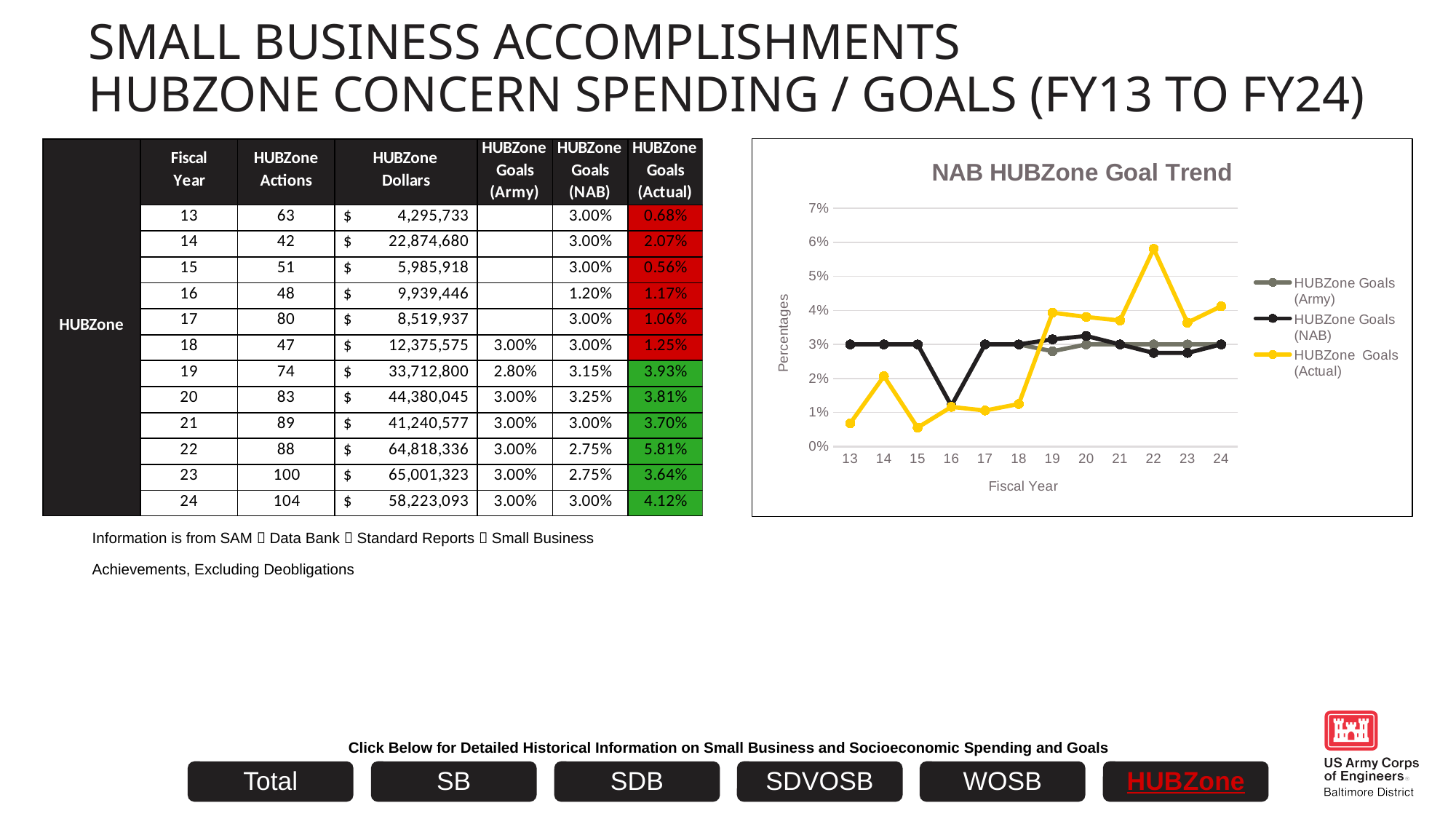
In fiscal year 19, which is larger: HUBZone Goals (Actual) or HUBZone Goals (NAB)? HUBZone Goals (Actual) How many series does the legend of the NAB HUBZone Goal Trend chart list? 3 What kind of chart is the NAB HUBZone Goal Trend chart? line chart What is the difference between the HUBZone Goals (Actual) values for fiscal year 22 and fiscal year 23? 2.17% What is the HUBZone Goals (NAB) value for fiscal year 16? 1.20% In the NAB HUBZone Goal Trend chart, is the HUBZone Goals (Actual) value for fiscal year 22 greater or less than 5%? greater What is the HUBZone Goals (Actual) value for fiscal year 24? 4.12% How many fiscal years are shown on the x axis of the NAB HUBZone Goal Trend chart? 12 In the NAB HUBZone Goal Trend chart, in which fiscal year is the HUBZone Goals (Actual) value highest? 22 In the NAB HUBZone Goal Trend chart, is the HUBZone Goals (Actual) value for fiscal year 13 greater or less than 1%? less In the NAB HUBZone Goal Trend chart, in which fiscal year is the HUBZone Goals (Actual) value lowest? 15 What is the title of the chart on the right side of the slide? NAB HUBZone Goal Trend